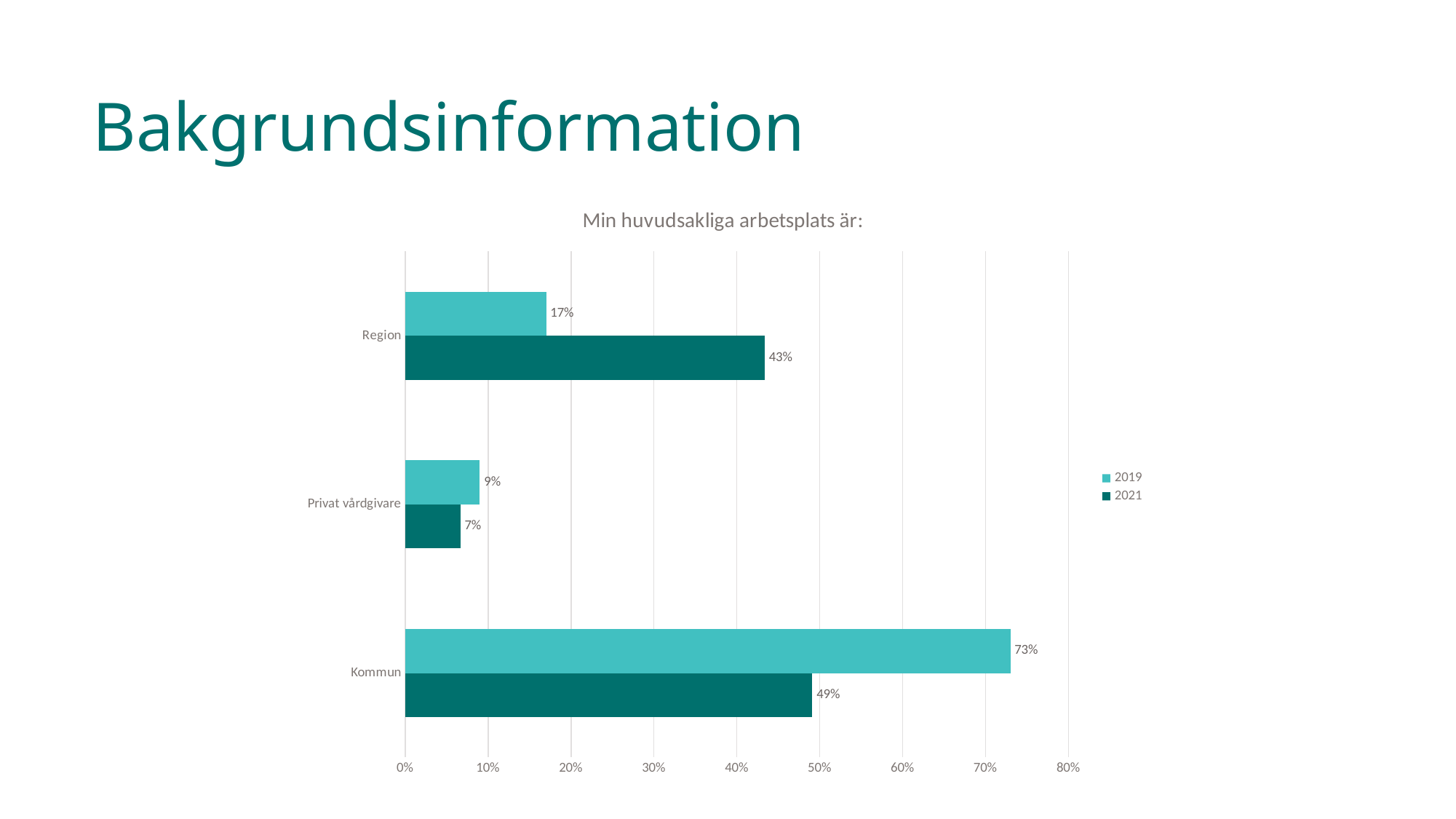
How many categories are shown on the chart? 3 What is the value for Kommun in the 2021 series? 49% What is the value for Region in the 2021 series? 43% What is the value for Region in the 2019 series? 17% How many series does the legend list? 2 What kind of chart is shown on the slide? Bar chart What is the title of the chart? Min huvudsakliga arbetsplats är: Which category has the highest value in the 2019 series? Kommun Which is larger for Region: the 2019 value or the 2021 value? 2021 Which category has the lowest value in the 2021 series? Privat vårdgivare What is the value for Privat vårdgivare in the 2019 series? 9% What is the difference between the 2019 and 2021 values for Kommun? 24%